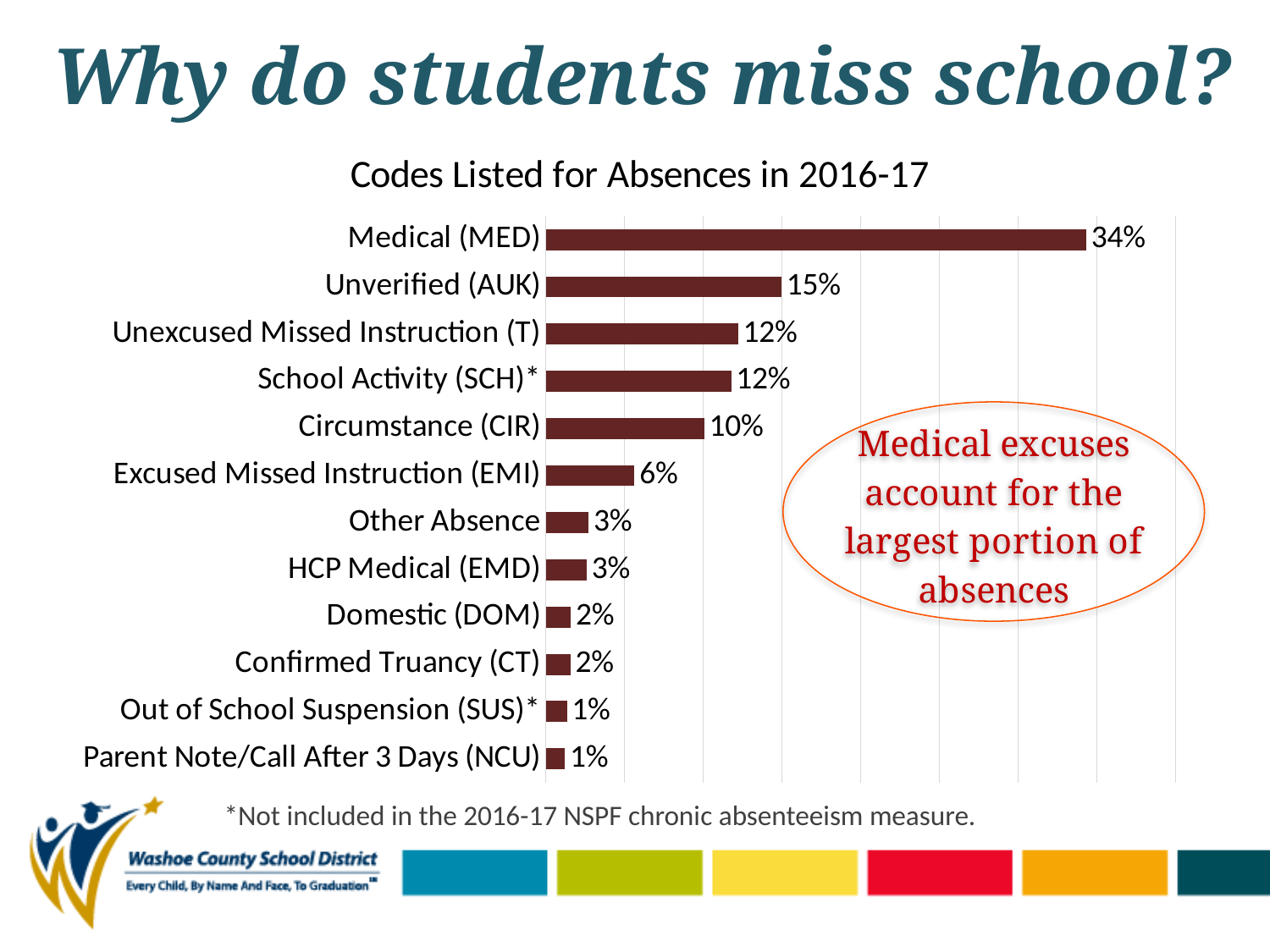
Which category has the highest value? Medical (MED) What is the value for Circumstance (CIR)? 10% What is the difference between the values for Circumstance (CIR) and Excused Missed Instruction (EMI)? 4% What is the value for Excused Missed Instruction (EMI)? 6% What is the value for Unverified (AUK)? 15% What is the value for Medical (MED)? 34% How many categories are shown in the chart? 12 What kind of chart is shown on the slide? Bar chart What is the value for Domestic (DOM)? 2% Which is larger, the value for Unverified (AUK) or the value for Circumstance (CIR)? Unverified (AUK) What is the difference between the values for Medical (MED) and Unverified (AUK)? 19% What is the title of the chart? Codes Listed for Absences in 2016-17